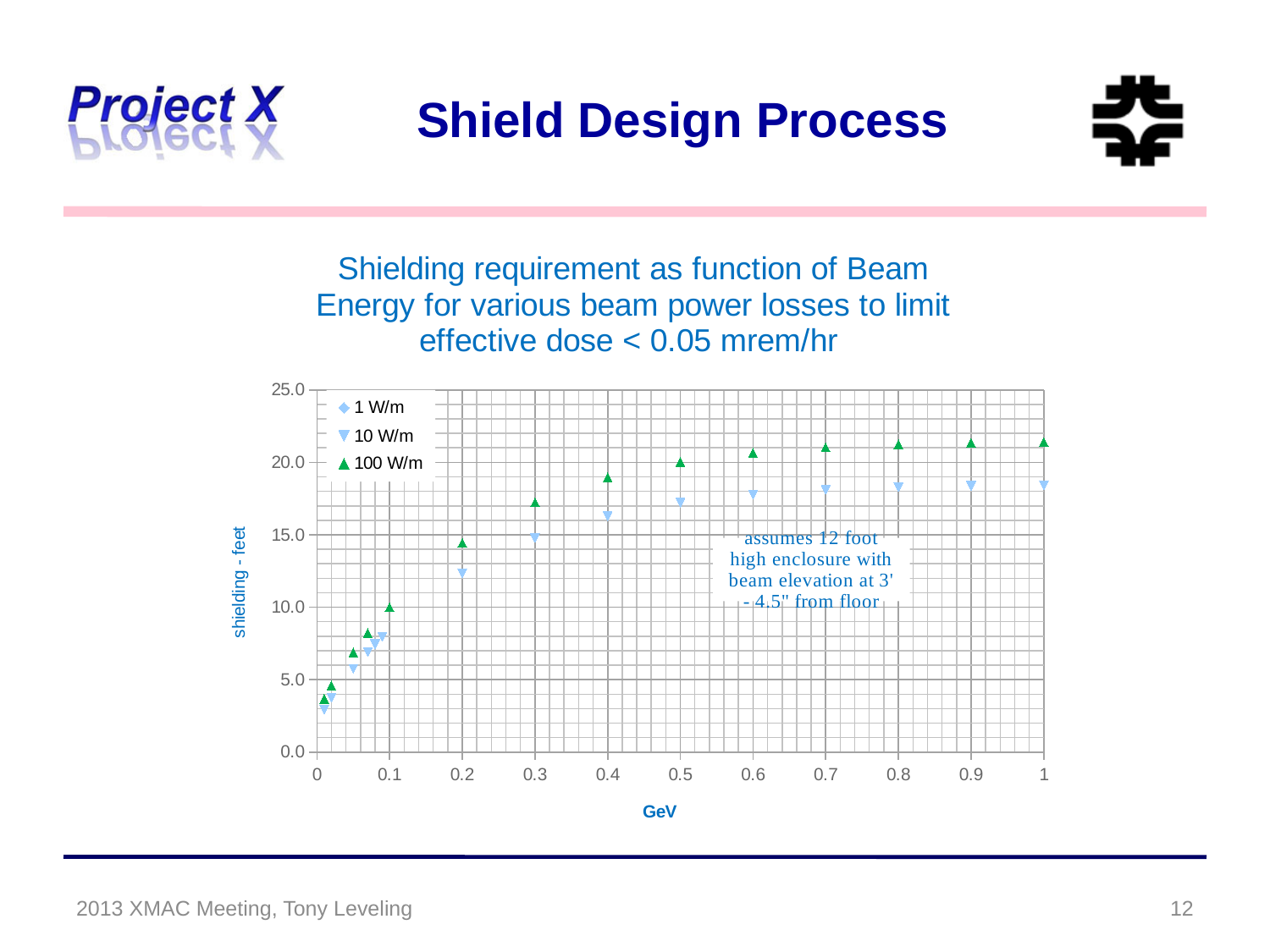
Is the shielding value for the 100 W/m series at 1 GeV greater or less than 20.0? greater At 0.3 GeV, which series has the higher shielding value, 100 W/m or 10 W/m? 100 W/m Does the shielding requirement for the 100 W/m series rise or fall as beam energy increases along the x axis? rise At 1 GeV, which series requires more shielding, 100 W/m or 10 W/m? 100 W/m Is the shielding value for the 10 W/m series at 0.2 GeV greater or less than 10.0? greater What are the three series listed in the chart's legend? 1 W/m, 10 W/m, 100 W/m What is the label on the chart's vertical axis? shielding - feet How many series does the chart's legend list? 3 Is the shielding value for the 100 W/m series at 0.2 GeV greater or less than 15.0? less What kind of chart is shown on the slide? scatter chart